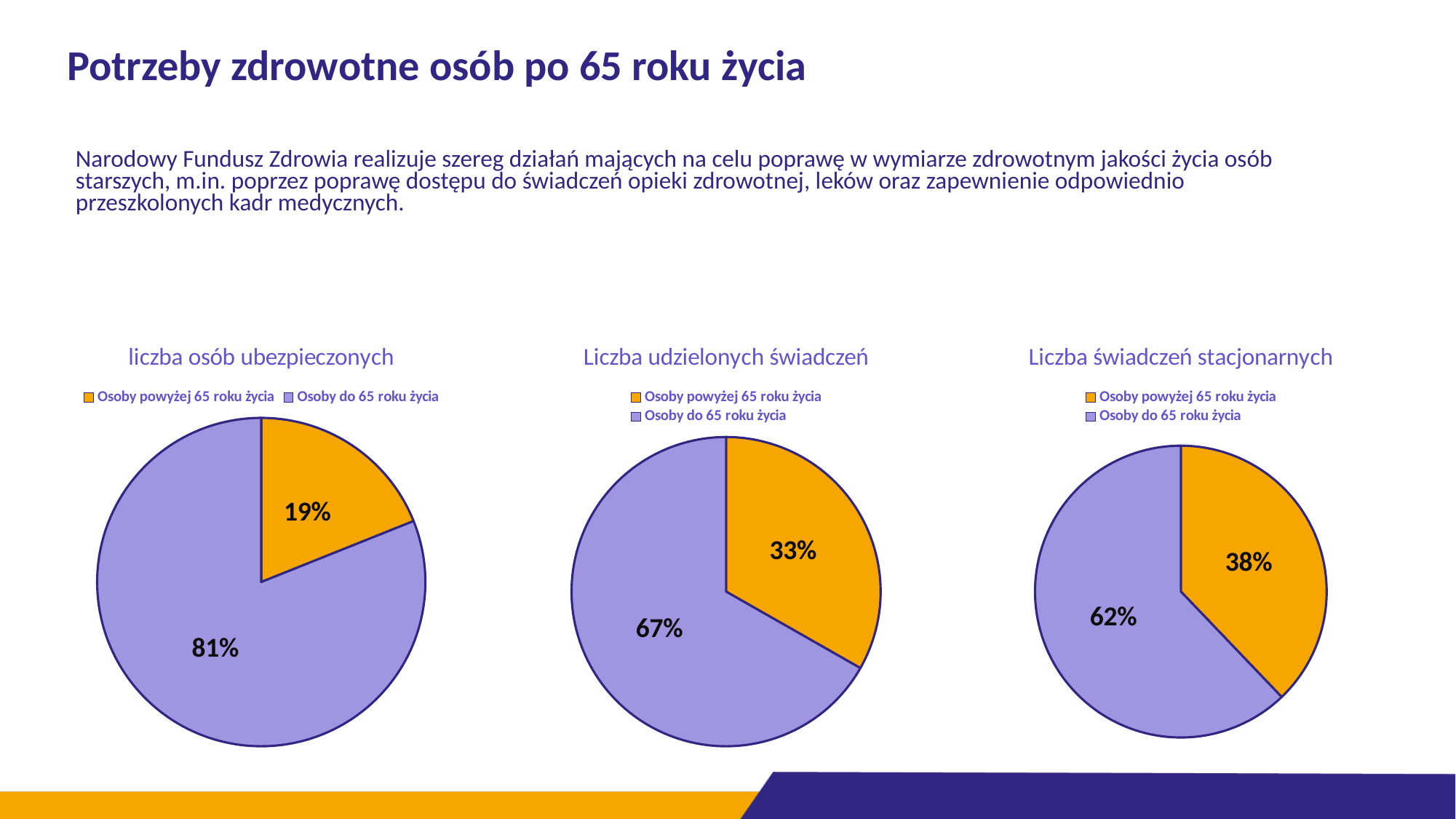
How many slices does the 'liczba osób ubezpieczonych' pie chart have? 2 In the 'liczba osób ubezpieczonych' chart, what share of the pie is 'Osoby do 65 roku życia'? 81% In the 'Liczba świadczeń stacjonarnych' chart, what share of the pie is 'Osoby do 65 roku życia'? 62% What type of chart is the 'Liczba udzielonych świadczeń' chart? Pie chart Which is larger: the 'Osoby powyżej 65 roku życia' share in the 'Liczba udzielonych świadczeń' chart or in the 'Liczba świadczeń stacjonarnych' chart? Liczba świadczeń stacjonarnych In the 'Liczba świadczeń stacjonarnych' chart, what share of the pie is 'Osoby powyżej 65 roku życia'? 38% In the 'Liczba udzielonych świadczeń' chart, what is the difference between the 'Osoby do 65 roku życia' and 'Osoby powyżej 65 roku życia' shares? 34% In the 'Liczba świadczeń stacjonarnych' chart, which slice is the smallest? Osoby powyżej 65 roku życia In the 'liczba osób ubezpieczonych' chart, which slice is the largest? Osoby do 65 roku życia